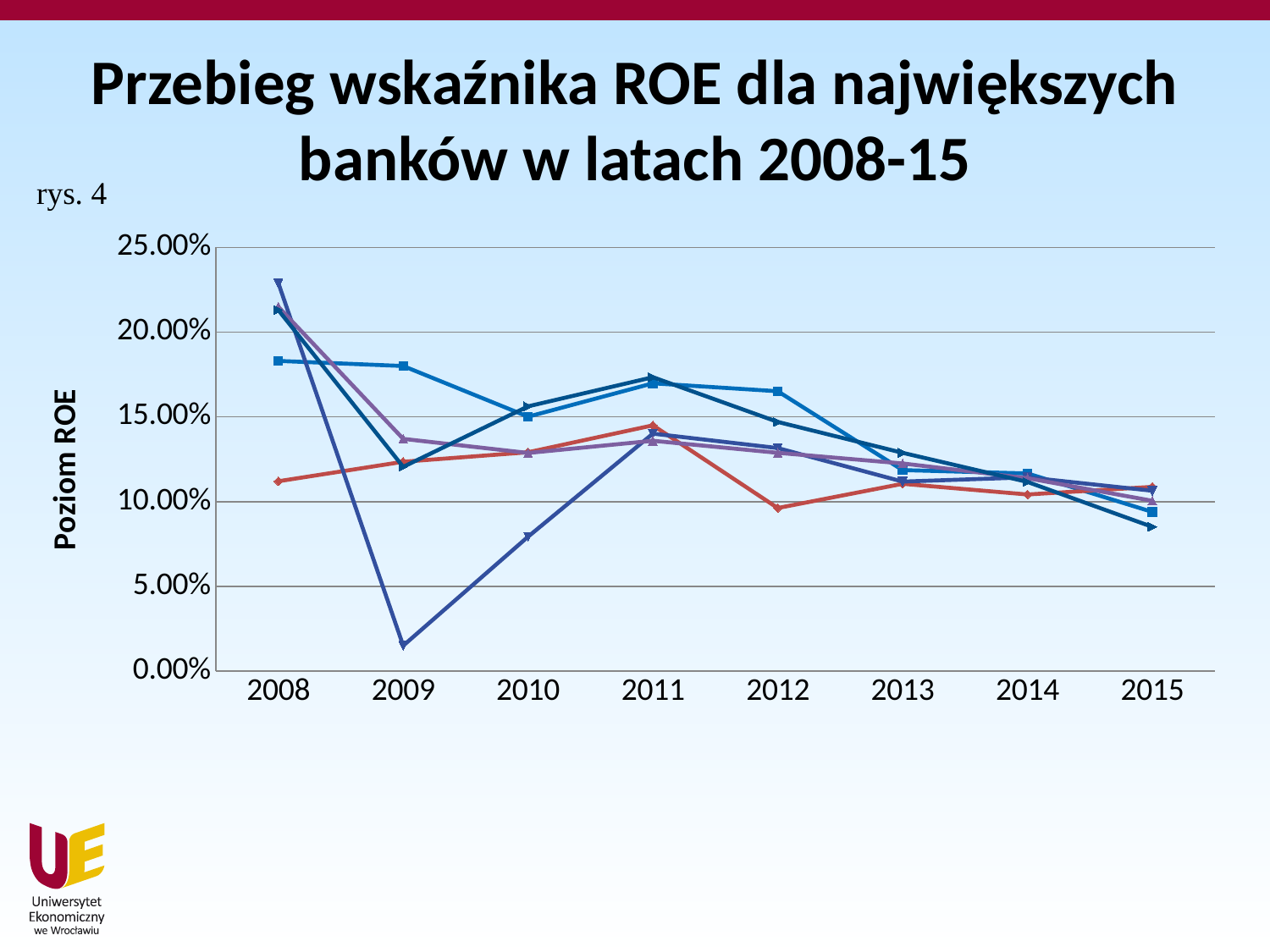
In which year does the chart reach its highest plotted value? 2008 What kind of chart is shown on the slide? line chart What is the label of the vertical axis of the chart? Poziom ROE Overall, do the ROE values rise or fall between 2008 and 2015? fall Are all the values plotted for 2015 greater or less than 15.00%? less How many lines are plotted on the chart? 5 What is the title of the chart on the slide? Przebieg wskaźnika ROE dla największych banków w latach 2008-15 Is the lowest value plotted in 2009 greater or less than 5.00%? less In which year does the chart reach its lowest plotted value? 2009 Is the highest value plotted in 2008 greater or less than 20.00%? greater How many years are shown on the x axis of the chart? 8